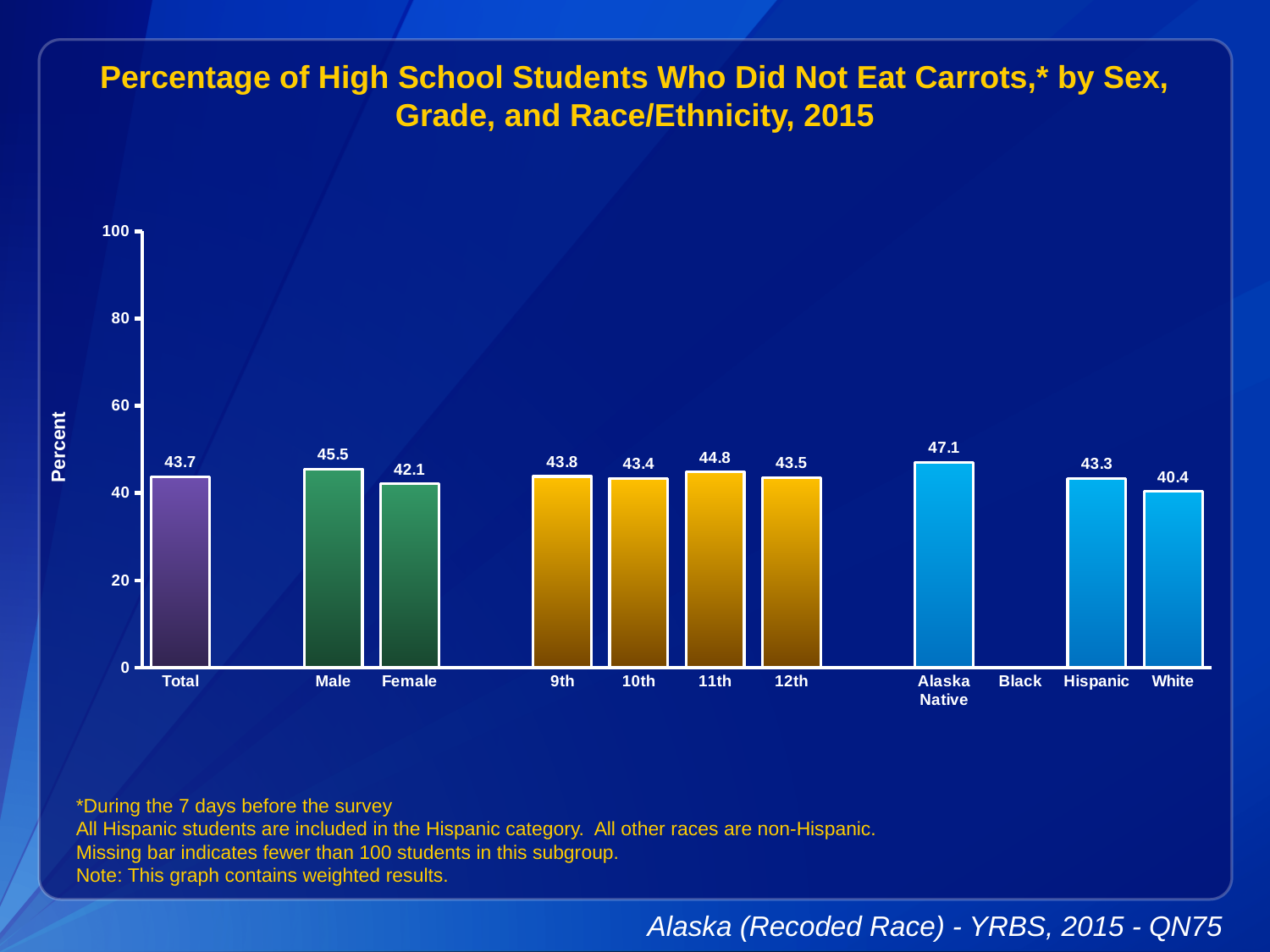
Which is larger, the value for 9th grade or 12th grade? 9th What is the value for Female? 42.1 How many categories have a bar plotted? 10 Which category has no bar shown? Black What is the value for Total? 43.7 Which category has the lowest value among the bars shown? White Which category has the highest value? Alaska Native What is the value for Alaska Native? 47.1 What is the value for 11th grade? 44.8 What kind of chart is this? bar chart What is the difference between the Male and Female values? 3.4 Is the value for Hispanic greater or less than 60? less